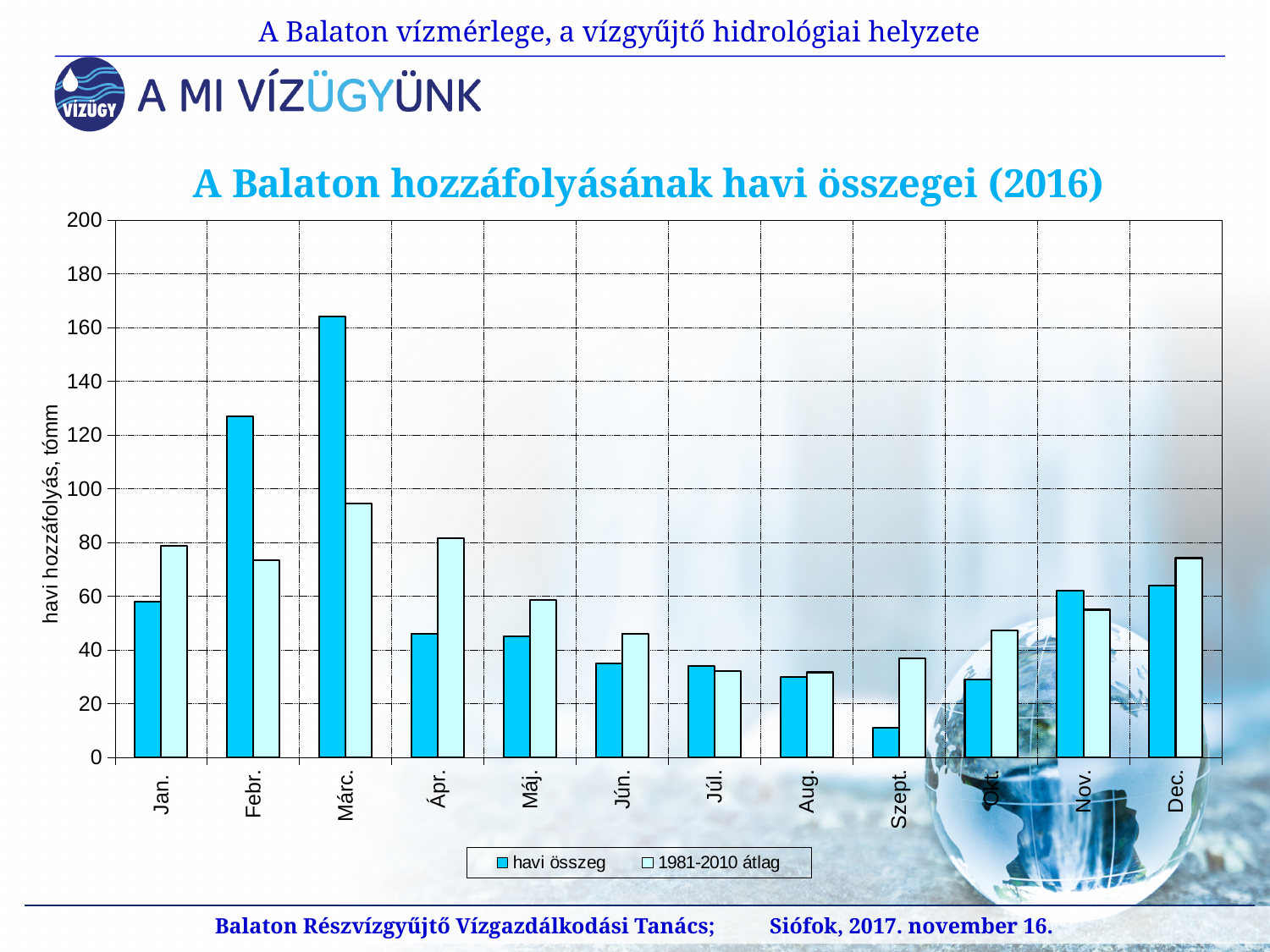
What is the label of the y axis? havi hozzáfolyás, tómm For Ápr., which is larger: 'havi összeg' or '1981-2010 átlag'? 1981-2010 átlag Is the 'havi összeg' value for Szept. greater or less than 20? less Which month has the highest '1981-2010 átlag' value? Márc. How many series does the legend list? 2 Which month has the lowest 'havi összeg' value? Szept. For Febr., which is larger: 'havi összeg' or '1981-2010 átlag'? havi összeg What kind of chart is shown on the slide? bar chart How many months are shown on the x axis? 12 Is the 'havi összeg' value for Febr. greater or less than 120? greater Is the 'havi összeg' value for Márc. greater or less than 140? greater Which month has the highest 'havi összeg' value? Márc.